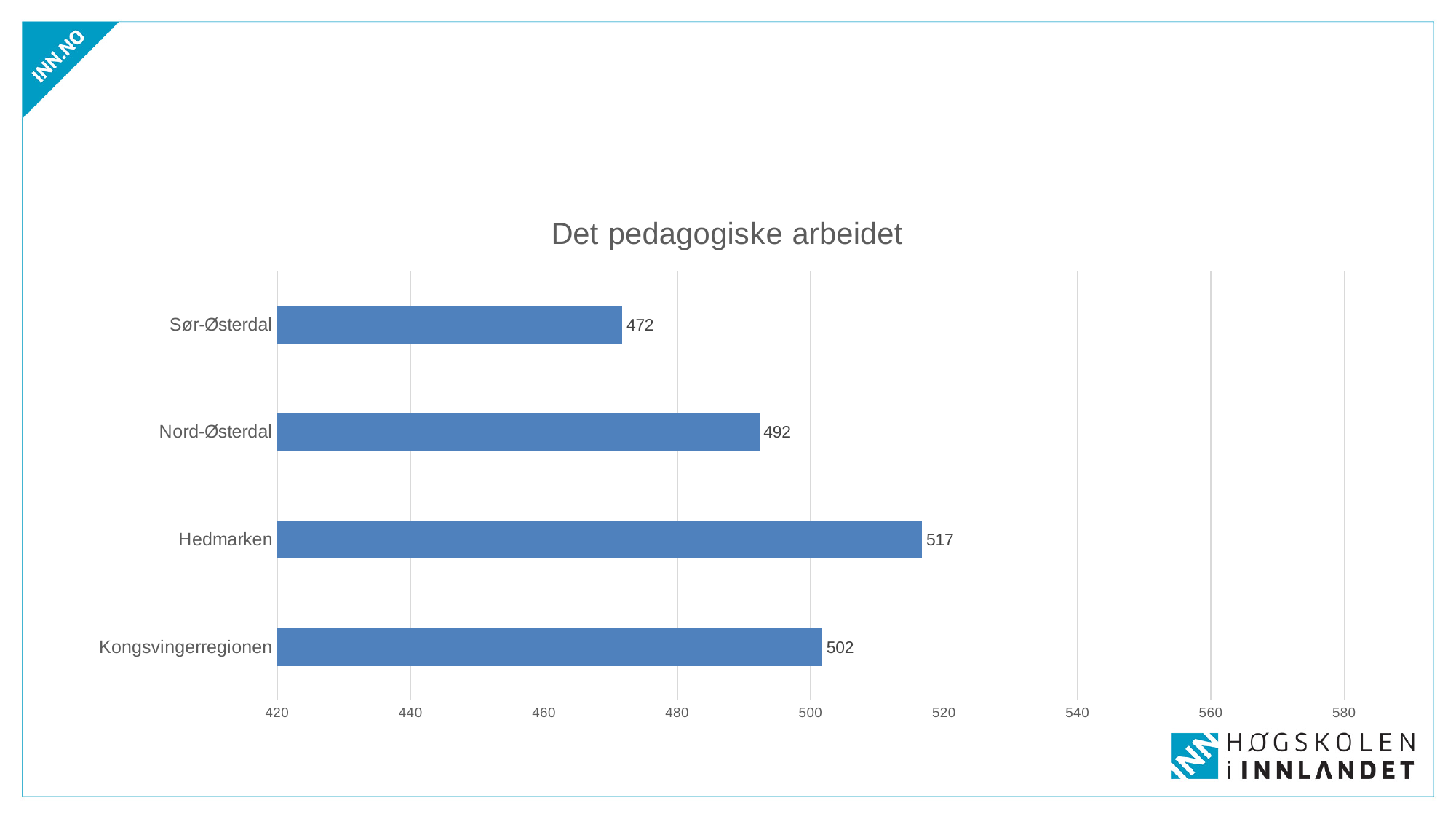
Which region has the highest value? Hedmarken What is the difference between the values for Kongsvingerregionen and Nord-Østerdal? 10 What is the value for Hedmarken? 517 How many regions are shown in the chart? 4 Which region has the lowest value? Sør-Østerdal What type of chart is shown on the slide? Bar chart What is the difference between the values for Hedmarken and Sør-Østerdal? 45 Is the value for Sør-Østerdal greater or less than 480? less What is the value for Kongsvingerregionen? 502 What is the value for Nord-Østerdal? 492 What is the value for Sør-Østerdal? 472 Which has a larger value, Nord-Østerdal or Kongsvingerregionen? Kongsvingerregionen